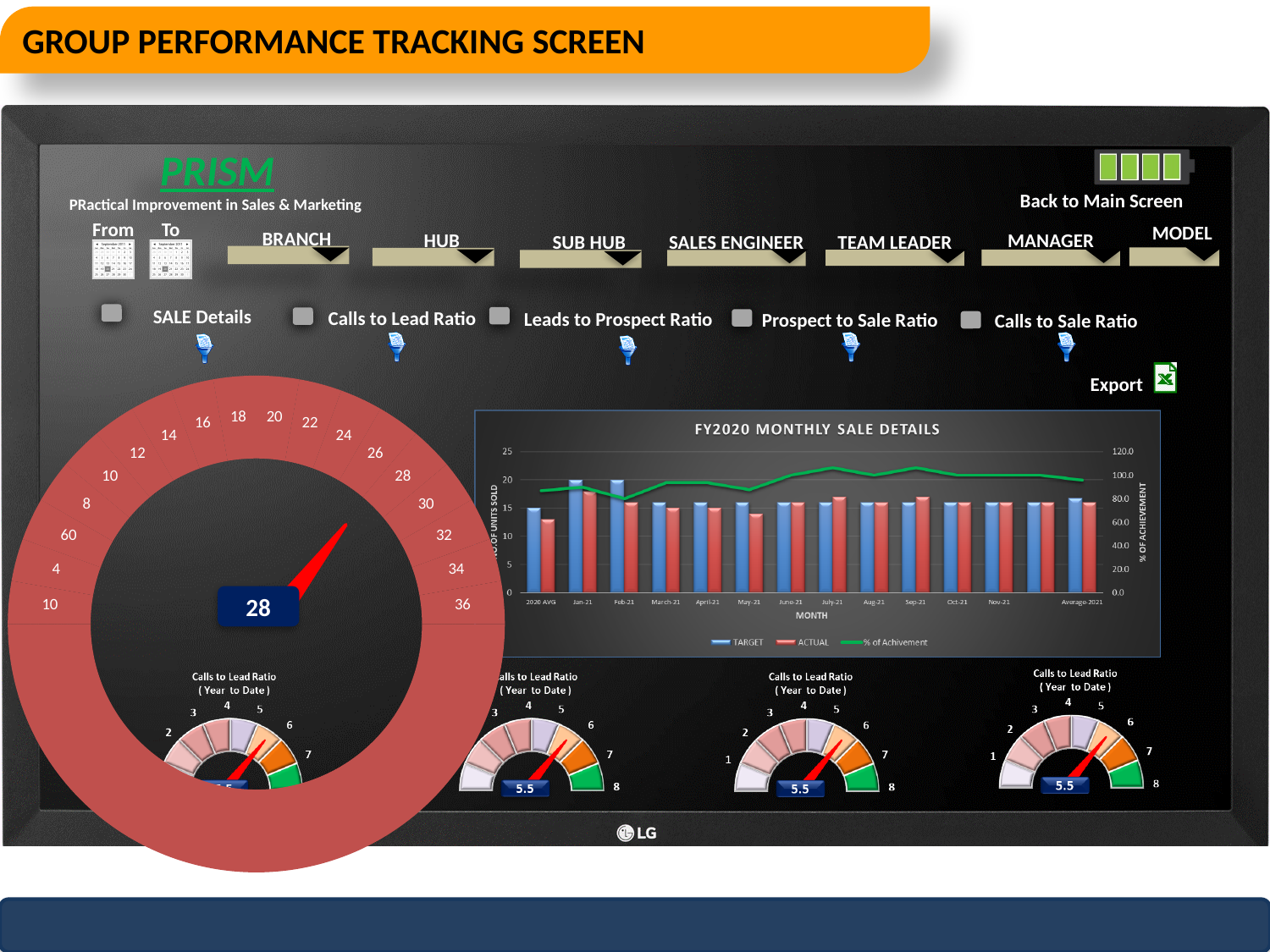
What is the title of the bar chart on the dashboard? FY2020 MONTHLY SALE DETAILS What kind of chart is the FY2020 MONTHLY SALE DETAILS chart? bar chart with a line What value is displayed on the large enlarged gauge on the left of the slide? 28 What value is displayed on the small Calls to Lead Ratio (Year to Date) gauge at the bottom right of the dashboard? 5.5 How many categories are shown on the x axis of the FY2020 MONTHLY SALE DETAILS chart? 13 In the FY2020 MONTHLY SALE DETAILS chart, is the ACTUAL value for 2020 AVG greater or less than 15? less In the FY2020 MONTHLY SALE DETAILS chart, is the TARGET value for Jan-21 greater or less than 15? greater How many series does the legend of the FY2020 MONTHLY SALE DETAILS chart list? 3 In the FY2020 MONTHLY SALE DETAILS chart, which is larger for Jan-21, TARGET or ACTUAL? TARGET What is the x-axis title of the FY2020 MONTHLY SALE DETAILS chart? MONTH In the FY2020 MONTHLY SALE DETAILS chart, is the ACTUAL value for May-21 greater or less than 15? less In the FY2020 MONTHLY SALE DETAILS chart, which is larger for Feb-21, TARGET or ACTUAL? TARGET